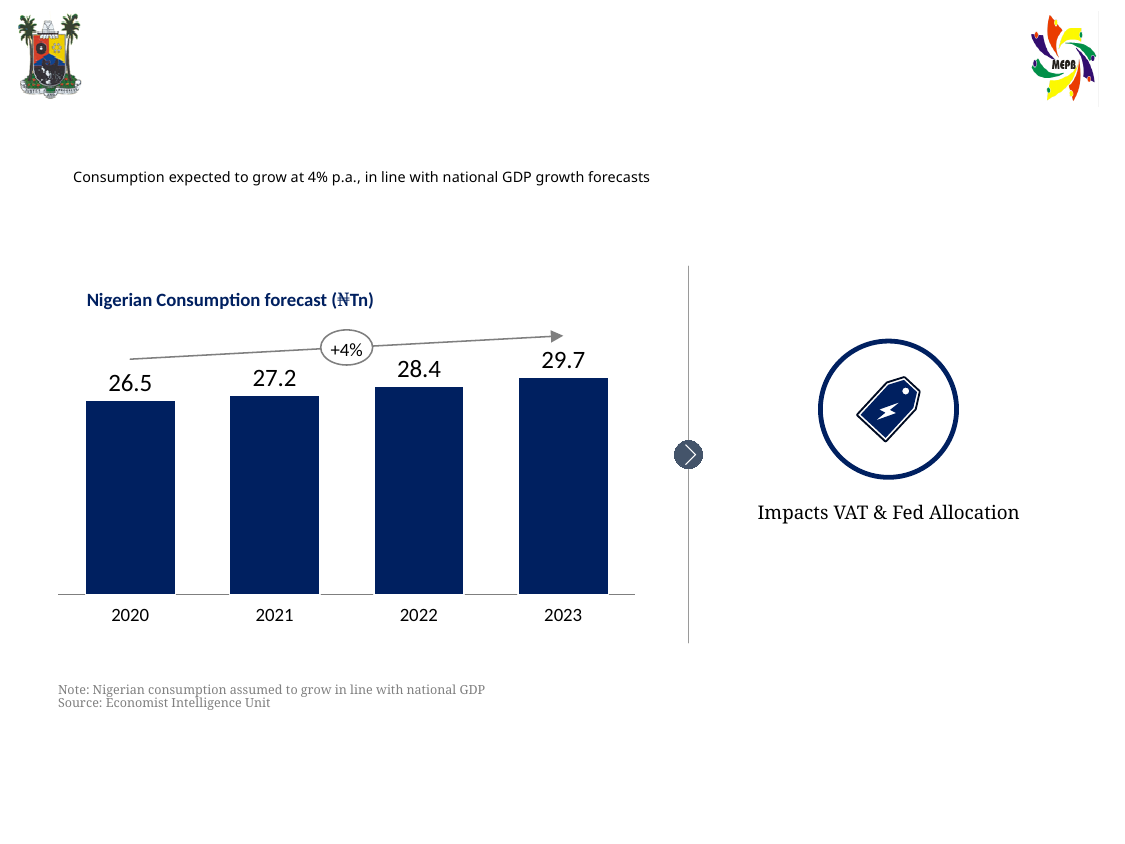
What type of chart is used to show the Nigerian consumption forecast? Bar chart How many years are shown in the chart? 4 Which year has the lowest consumption forecast? 2020 What is the Nigerian consumption forecast for 2023? 29.7 Which year has the highest consumption forecast? 2023 What is the Nigerian consumption forecast for 2022? 28.4 Do the consumption forecast values rise or fall from 2020 to 2023? Rise What is the difference between the 2023 and 2020 consumption forecasts? 3.2 What annual growth rate is labelled on the arrow above the bars? +4% Which is larger, the forecast for 2021 or for 2022? 2022 What is the Nigerian consumption forecast for 2021? 27.2 What is the Nigerian consumption forecast for 2020? 26.5